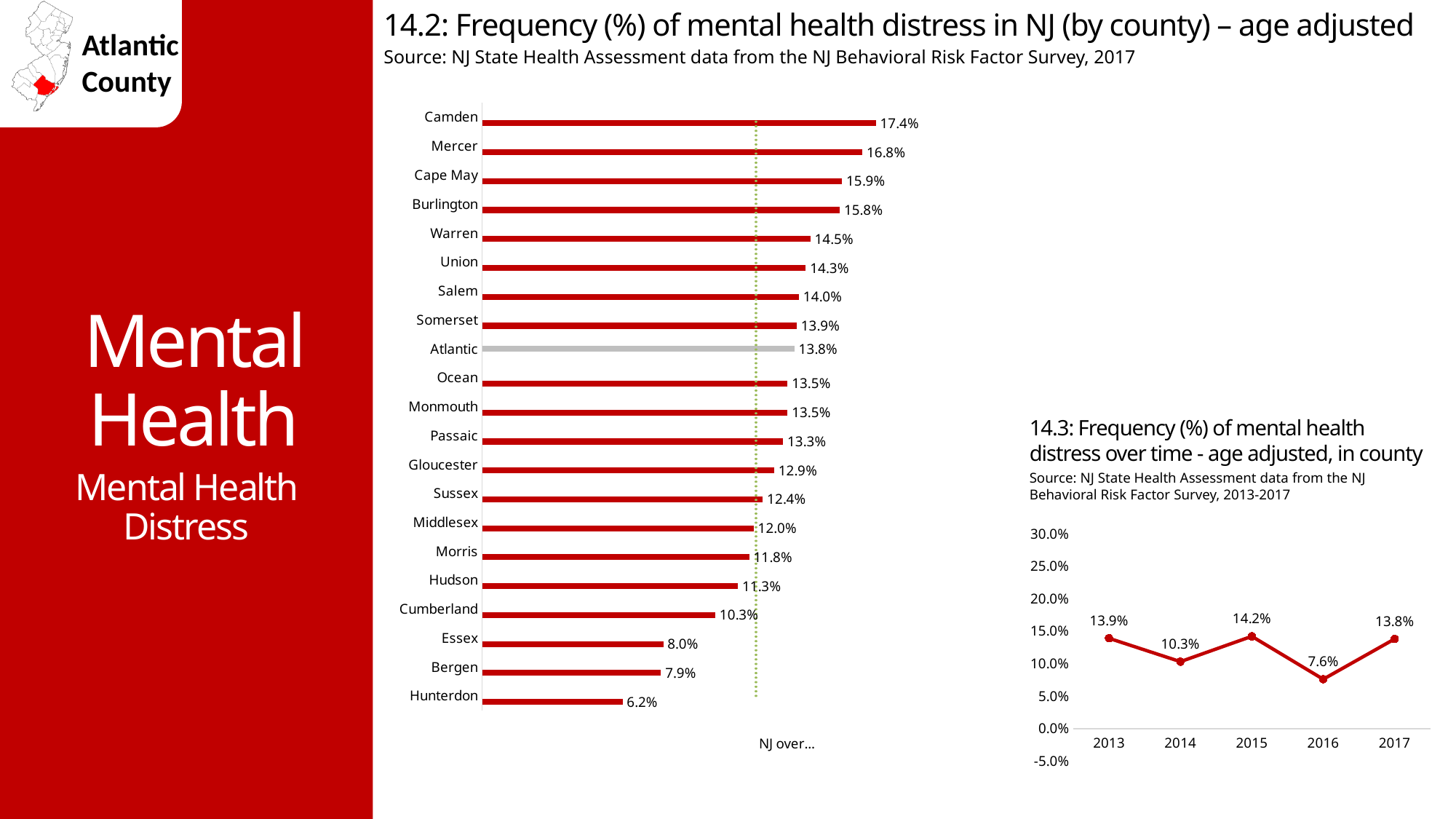
In chart 14.3 (over time), what is the value for 2016? 7.6% In chart 14.3 (over time), which year has the highest value? 2015 In chart 14.2 (by county), how many counties are plotted? 21 In chart 14.2 (by county), which county has the lowest value? Hunterdon In chart 14.2 (by county), which is larger, the value for Mercer or the value for Cape May? Mercer In chart 14.2 (by county), which county has the highest value? Camden What kind of chart is chart 14.2 (by county)? Bar chart In chart 14.2 (by county), what is the value for Cumberland? 10.3% In chart 14.3 (over time), how many years are plotted? 5 In chart 14.2 (by county), what is the value for Atlantic? 13.8% In chart 14.3 (over time), what is the difference between the 2015 and 2016 values? 6.6% In chart 14.2 (by county), what is the difference between Camden and Hunterdon? 11.2%